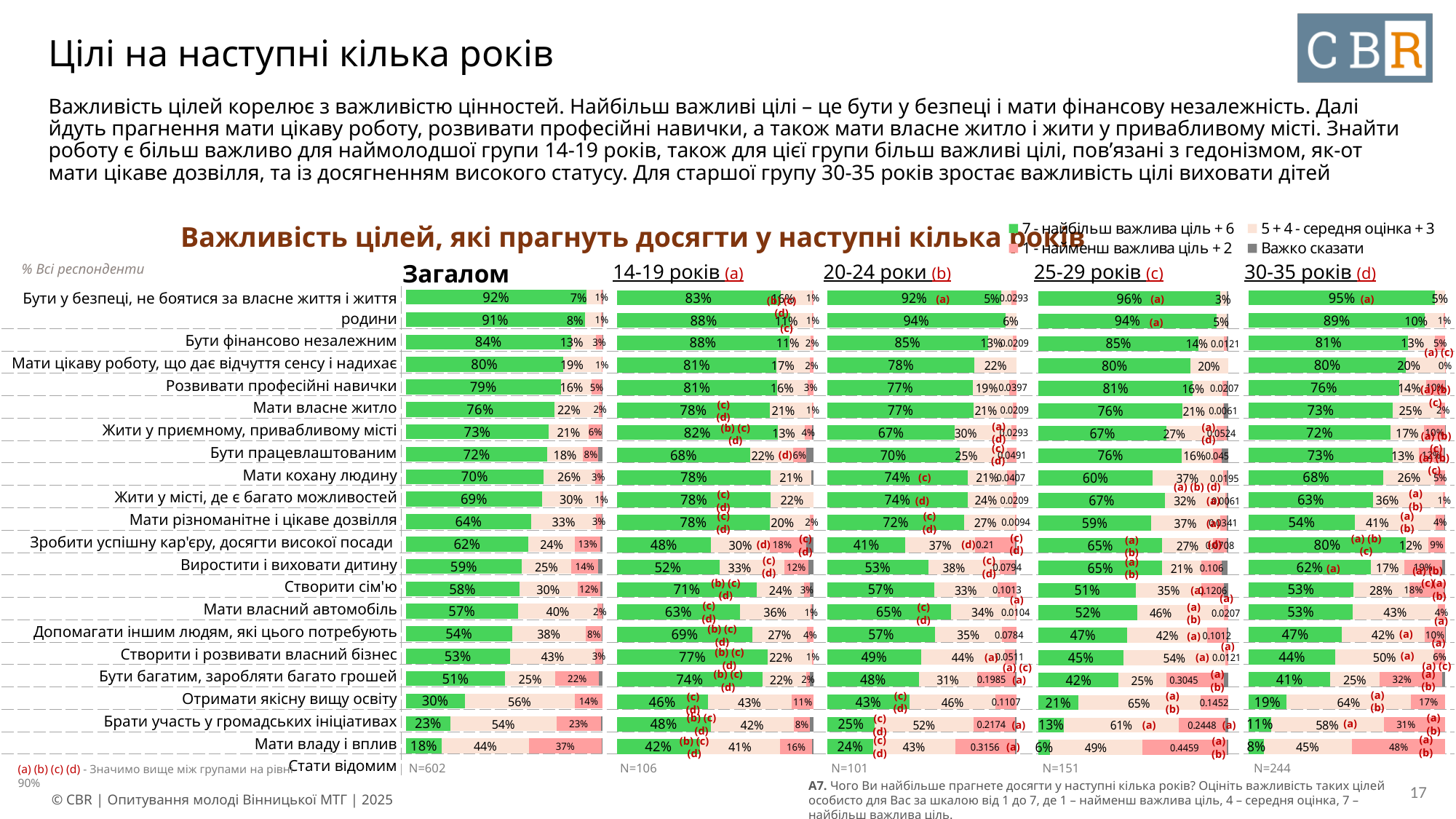
Across the four age-group charts, which group has the lowest green value for 'Бути у безпеці, не боятися за власне життя і життя родини'? 14-19 років What is the sample size (N) shown under the 'Загалом' chart? N=602 How many separate charts (respondent groups) are shown on the slide? 5 In the 'Загалом' chart, what share of respondents rated 'Бути у безпеці, не боятися за власне життя і життя родини' as a most important goal (green segment)? 92% What kind of chart is used on this slide to show the importance of goals? Stacked bar chart Which legend entry is shown in green? 7 - найбільш важлива ціль + 6 For 'Бути у безпеці, не боятися за власне життя і життя родини', is the green value larger in the '30-35 років' chart or the '20-24 роки' chart? 30-35 років In the '25-29 років' chart, what is the green (most important) value for 'Бути у безпеці, не боятися за власне життя і життя родини'? 96% What is the difference in percentage points between the '25-29 років' and '14-19 років' green values for 'Бути у безпеці, не боятися за власне життя і життя родини'? 13 percentage points How many series does the legend list for the goals charts? 4 In the '14-19 років' chart, what is the green (most important) value for 'Бути у безпеці, не боятися за власне життя і життя родини'? 83% Across the four age-group charts, which group has the highest green value for 'Бути у безпеці, не боятися за власне життя і життя родини'? 25-29 років